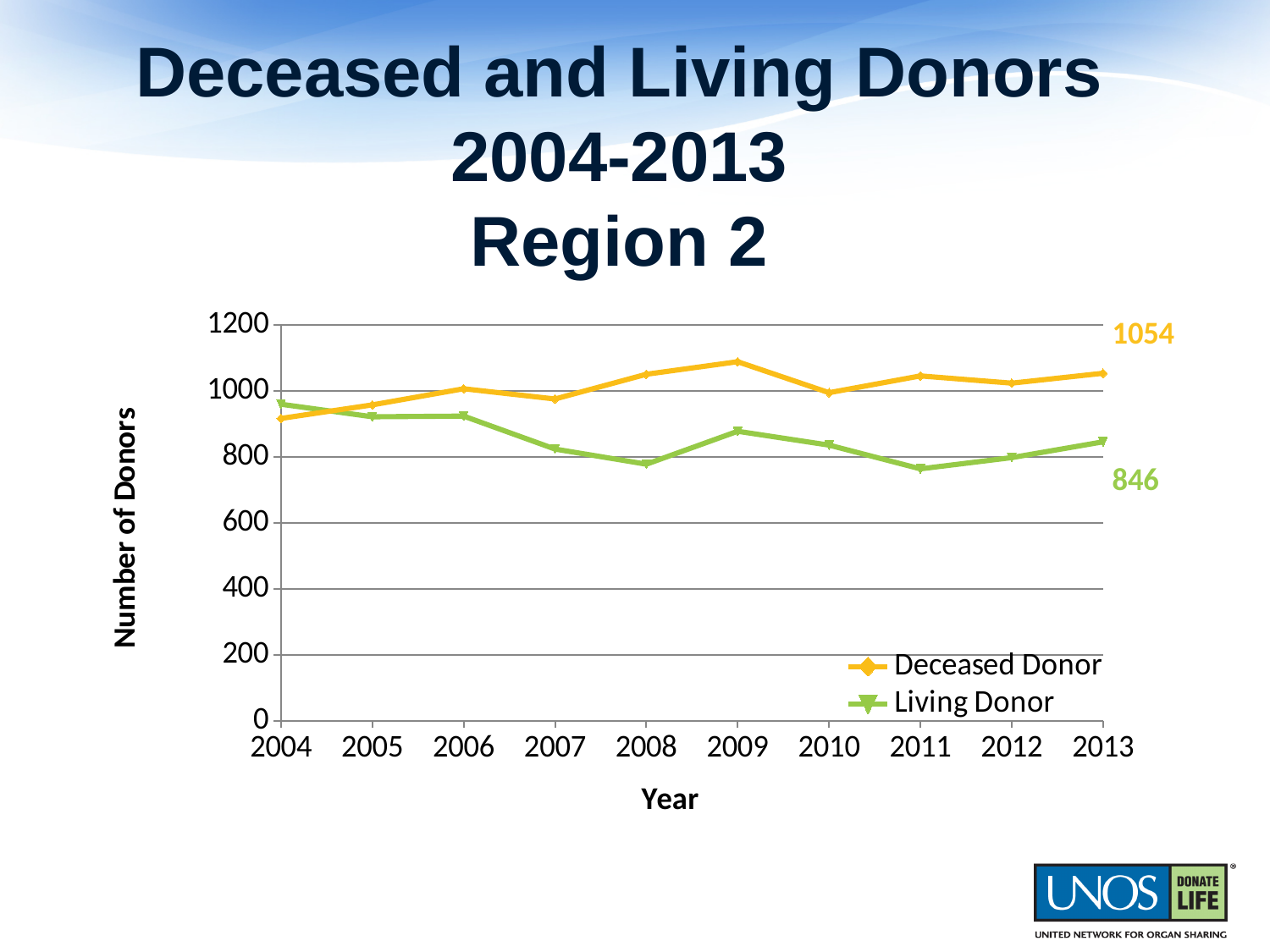
Is the value for Living Donor in 2011 greater or less than 800? less What is the difference between Deceased Donors and Living Donors in 2013? 208 In 2013, which series has the larger value, Deceased Donor or Living Donor? Deceased Donor In which year does the Living Donor series reach its highest value? 2004 What kind of chart is shown on the slide? Line chart How many years are shown on the x axis? 10 Is the value for Deceased Donor in 2009 greater or less than 1000? greater How many series does the legend list? 2 What is the number of Deceased Donors in 2013? 1054 What is the number of Living Donors in 2013? 846 In 2004, which series has the larger value, Deceased Donor or Living Donor? Living Donor In which year does the Deceased Donor series reach its highest value? 2009